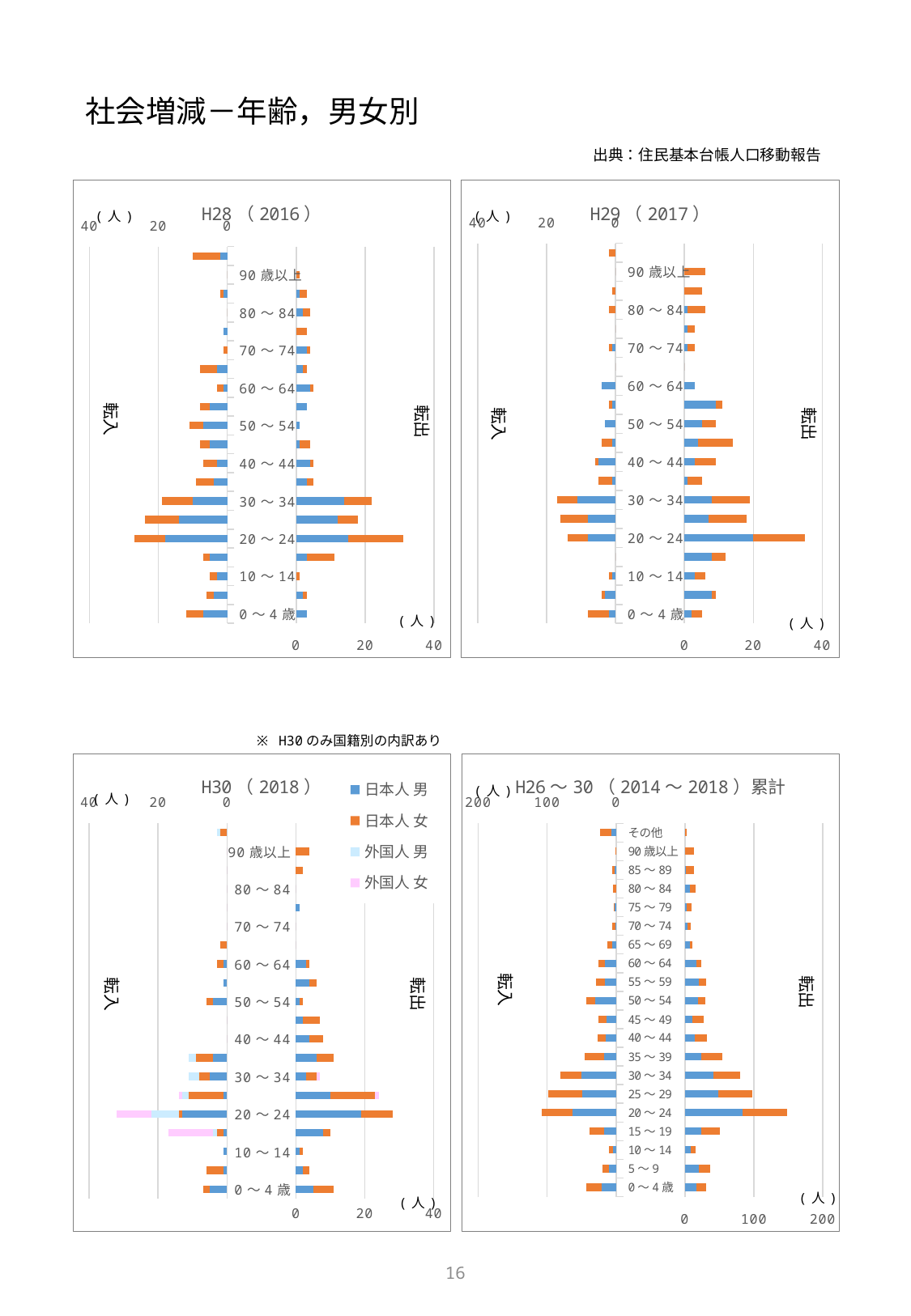
On the H29 (2017) chart, which is larger for 転出: 20～24 or 30～34? 20～24 What kind of chart is the H28 (2016) chart? bar chart How many series does the legend on the H30 (2018) chart list? 4 On the H26～30 (2014～2018) 累計 chart, how many age categories are listed on the axis? 20 Which of the four charts includes a breakdown by nationality (外国人)? H30 (2018) On the H26～30 (2014～2018) 累計 chart, which age group has the largest 転入 bar? 20～24 On the H26～30 (2014～2018) 累計 chart, is the 転出 value for 20～24 greater or less than 100? greater On the H28 (2016) chart, is the 転出 value for 20～24 greater or less than 20? greater On the H28 (2016) chart, which age group has the largest 転出 bar? 20～24 On the H29 (2017) chart, which age group has the largest 転出 bar? 20～24 On the H30 (2018) chart, is the 転出 value for 20～24 greater or less than 20? greater What source is cited for the charts on the slide? 住民基本台帳人口移動報告